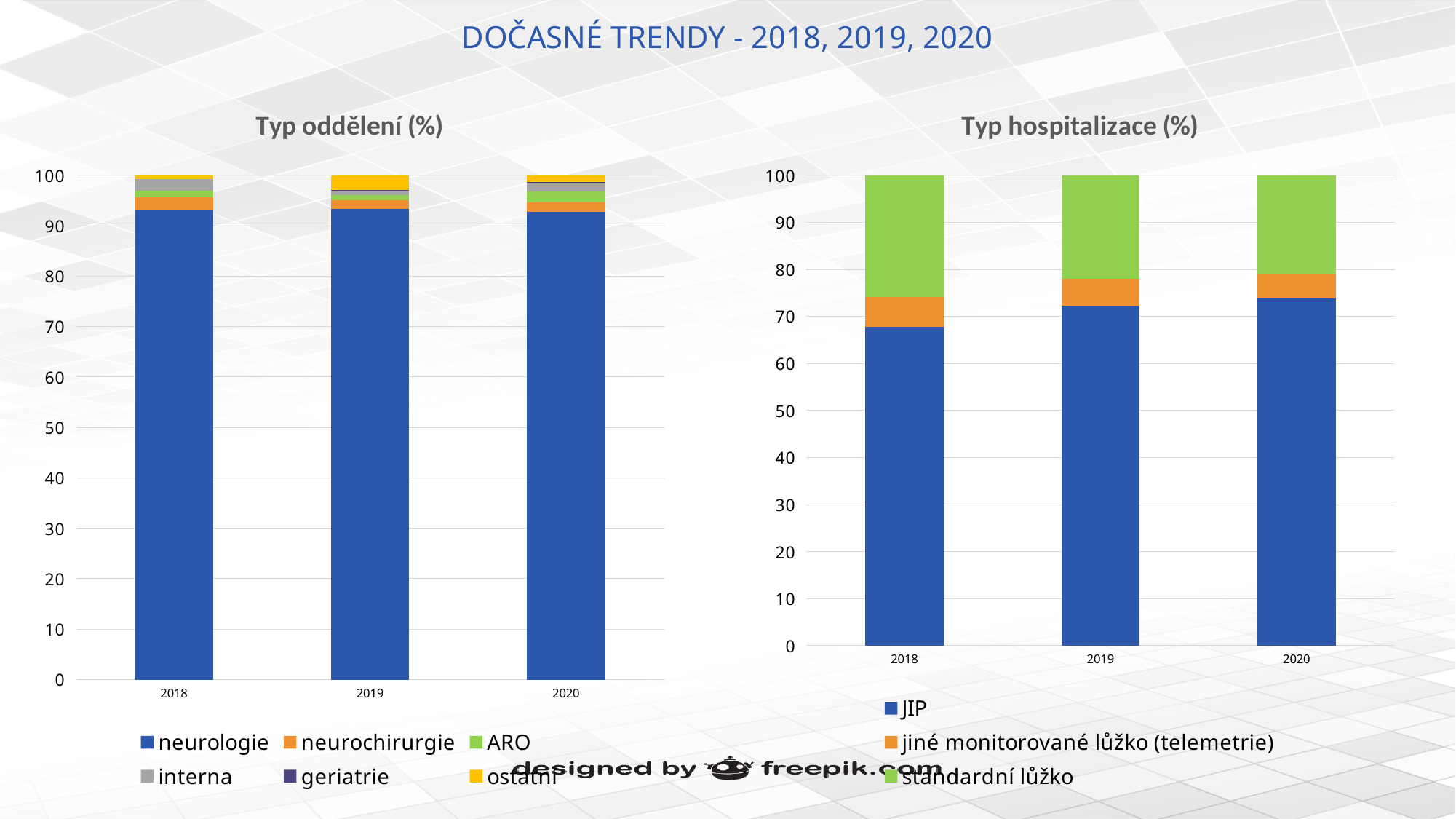
In the 'Typ hospitalizace (%)' chart, which year has the largest standardní lůžko share? 2018 In the 'Typ hospitalizace (%)' chart, does the standardní lůžko share rise or fall from 2018 to 2020? fall How many years are shown on the x axis of the 'Typ hospitalizace (%)' chart? 3 In the 'Typ hospitalizace (%)' chart, is the value for JIP in 2020 greater or less than 70? greater In the 'Typ hospitalizace (%)' chart, which year has the lowest JIP share? 2018 How many series does the legend of the 'Typ hospitalizace (%)' chart list? 3 In the 'Typ oddělení (%)' chart, is the ostatní segment larger in 2019 or in 2018? 2019 In the 'Typ oddělení (%)' chart, is the value for neurologie in 2018 greater or less than 90? greater How many series does the legend of the 'Typ oddělení (%)' chart list? 6 What kind of chart is the 'Typ oddělení (%)' chart on the left? stacked bar chart In the 'Typ hospitalizace (%)' chart, is the value for JIP in 2018 greater or less than 70? less In the 'Typ hospitalizace (%)' chart, does the JIP share rise or fall from 2018 to 2020? rise